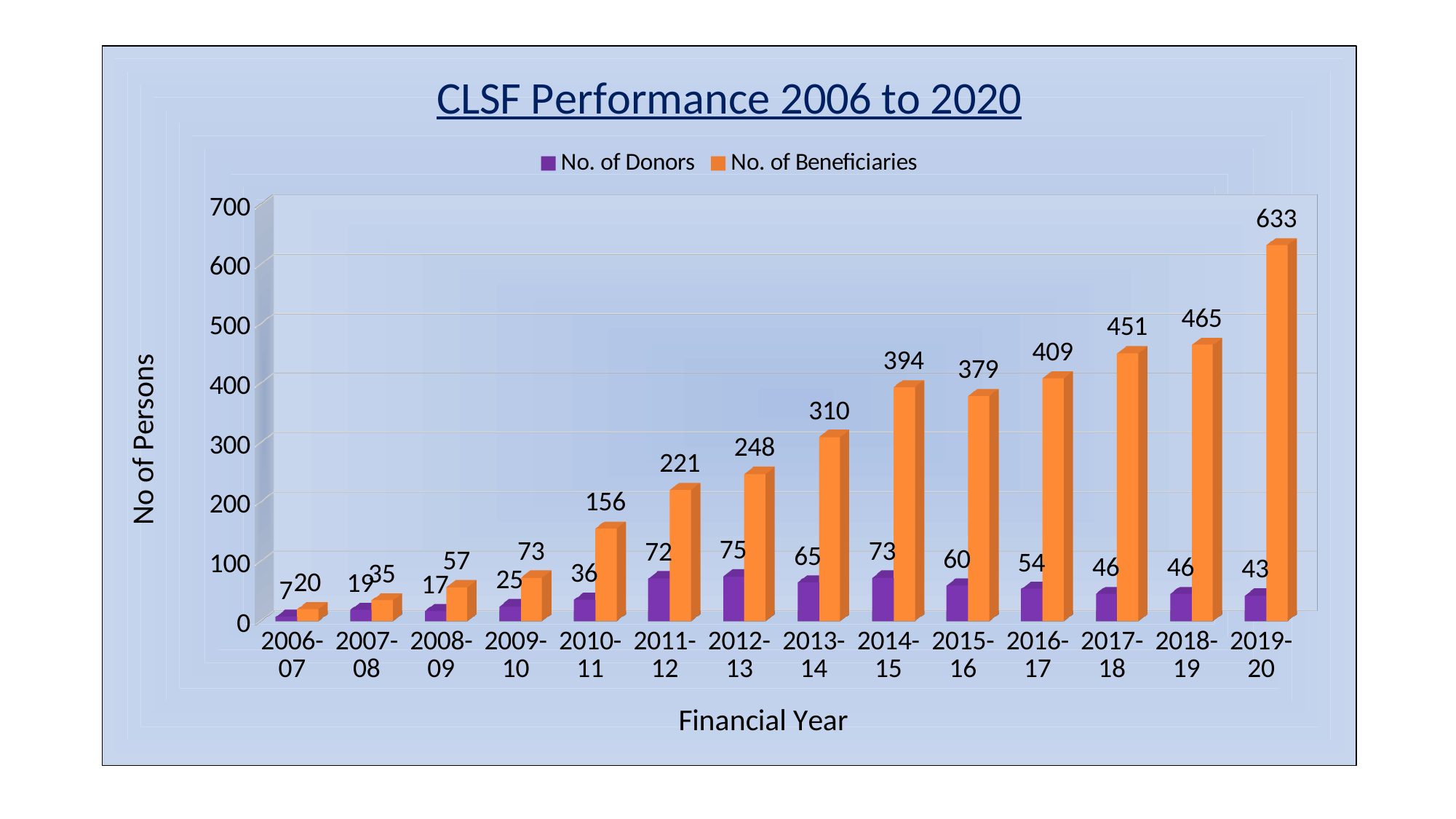
What is the difference between the number of beneficiaries in 2019-20 and 2018-19? 168 Which financial year has the highest number of beneficiaries? 2019-20 Is the number of beneficiaries in 2013-14 greater or less than 300? greater Which is larger, the number of donors in 2011-12 or in 2014-15? 2014-15 What kind of chart is shown on the slide? bar chart Which financial year has the lowest number of donors? 2006-07 How many financial years are shown on the x axis? 14 What is the title of the chart? CLSF Performance 2006 to 2020 How many series does the legend list? 2 Do the number of beneficiaries generally rise or fall from 2006-07 to 2019-20? rise What is the number of donors in 2012-13? 75 What is the number of beneficiaries in 2019-20? 633